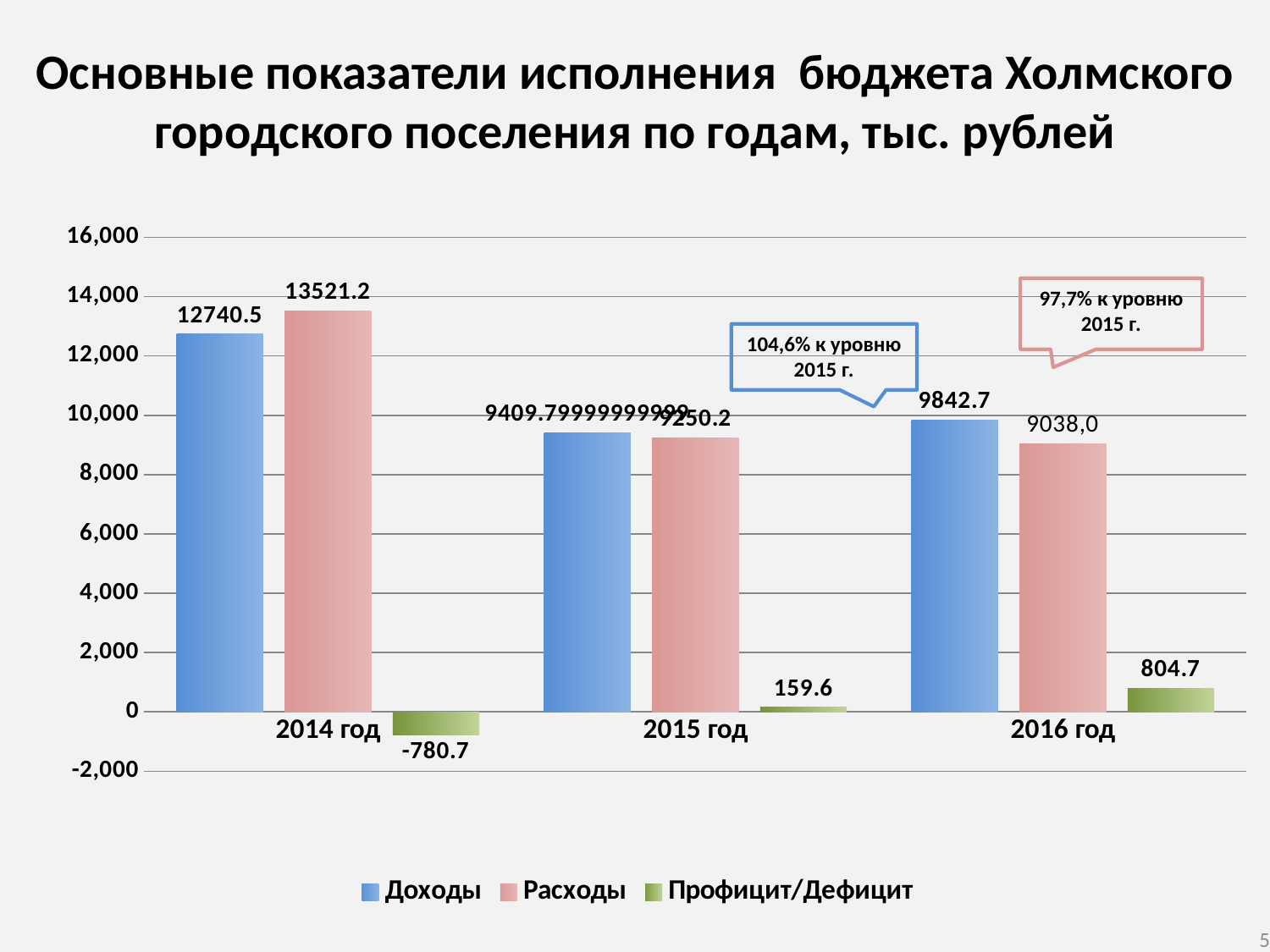
What is the value of Профицит/Дефицит for 2014 год? -780.7 What is the value of Доходы for 2016 год? 9842.7 What type of chart is shown on the slide? bar chart What is the value of Профицит/Дефицит for 2015 год? 159.6 What is the value of Доходы for 2014 год? 12740.5 In which year is Доходы the highest? 2014 год What is the value of Расходы for 2014 год? 13521.2 Which is larger in 2014 год, Доходы or Расходы? Расходы Is the value of Расходы for 2015 год greater or less than 10,000? less How many series does the legend list? 3 How many year categories are shown on the x axis? 3 What is the value of Профицит/Дефицит for 2016 год? 804.7